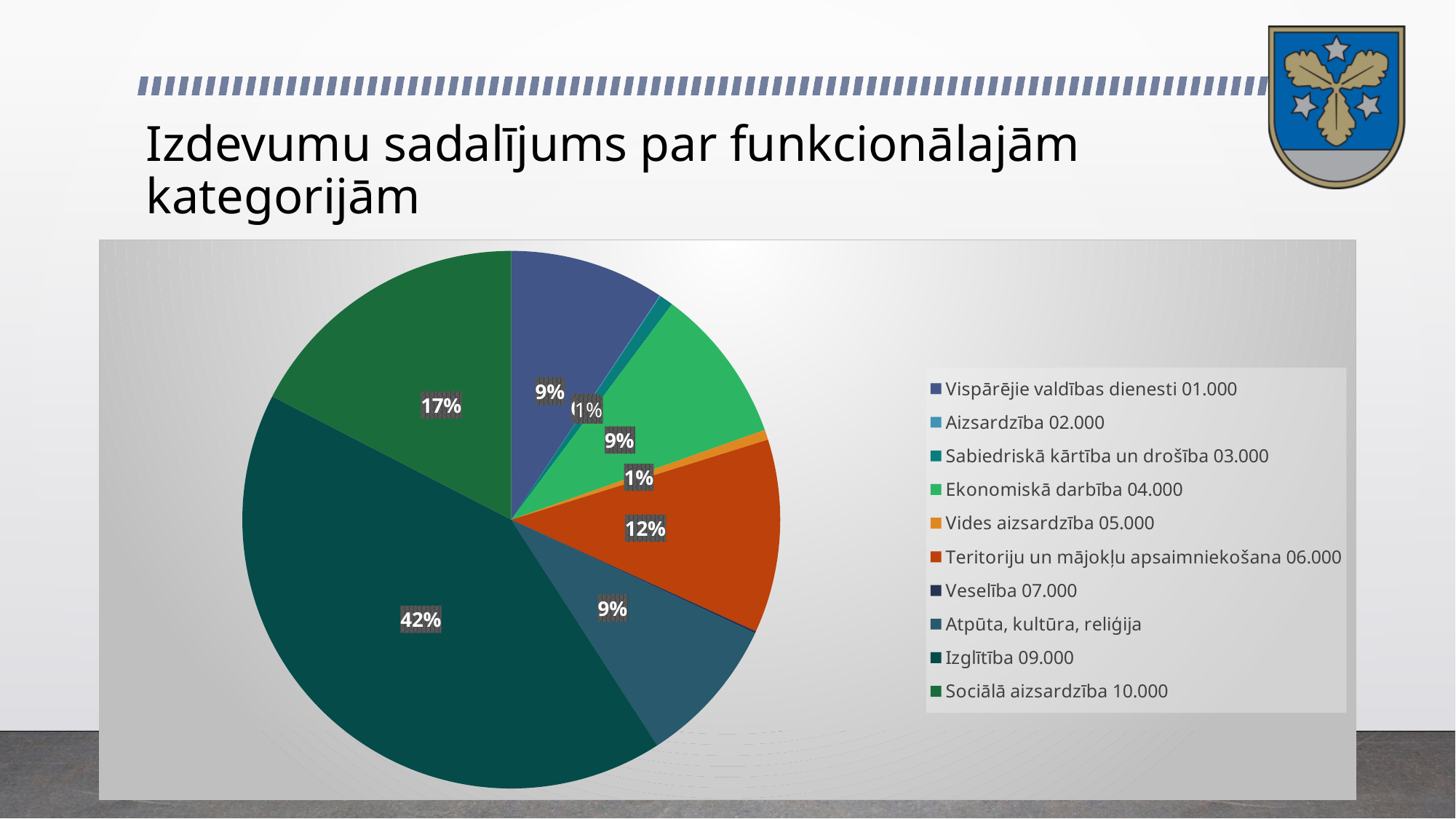
What share of the pie does Izglītība 09.000 have? 42% What share of the pie does Atpūta, kultūra, reliģija have? 9% By how many percentage points does the Izglītība 09.000 slice exceed the Sociālā aizsardzība 10.000 slice? 25 How many categories does the legend list? 10 What kind of chart is shown on the slide? pie chart What share of the pie does Vides aizsardzība 05.000 have? 1% What share of the pie does Ekonomiskā darbība 04.000 have? 9% Which slice is larger: Sociālā aizsardzība 10.000 or Teritoriju un mājokļu apsaimniekošana 06.000? Sociālā aizsardzība 10.000 What share of the pie does Teritoriju un mājokļu apsaimniekošana 06.000 have? 12% What is the title of the slide containing the chart? Izdevumu sadalījums par funkcionālajām kategorijām Which category has the largest slice of the pie? Izglītība 09.000 What share of the pie does Sociālā aizsardzība 10.000 have? 17%